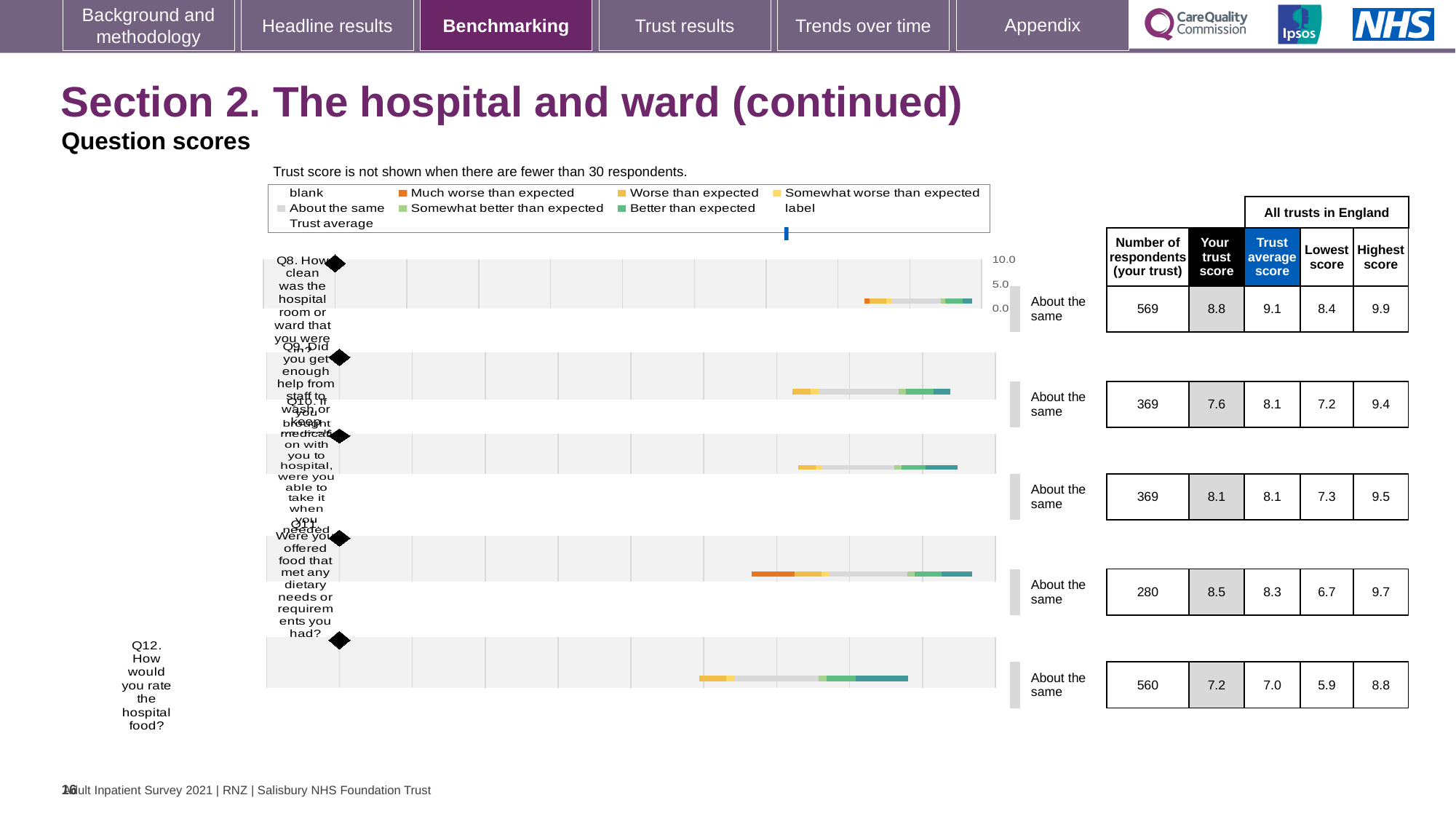
What is the lowest score across all trusts in England for Q12? 5.9 What kind of chart is used to show the question scores? Bar chart How many question rows (Q8 to Q12) are plotted in the benchmarking chart? 5 For Q11, which is larger: the 'Your trust score' or the 'Trust average score'? Your trust score What is the 'Your trust score' value for Q8 (how clean was the hospital room or ward)? 8.8 What is the difference between the highest score and the lowest score for Q8? 1.5 For Q9, how much higher is the 'Trust average score' than the 'Your trust score'? 0.5 Which legend entry is shown in dark orange? Much worse than expected How many respondents are listed for Q12 (how would you rate the hospital food)? 560 Which question has the lowest 'Your trust score'? Q12 Which question has the highest 'Your trust score'? Q8 What benchmark category label is shown next to each of the five question bars? About the same